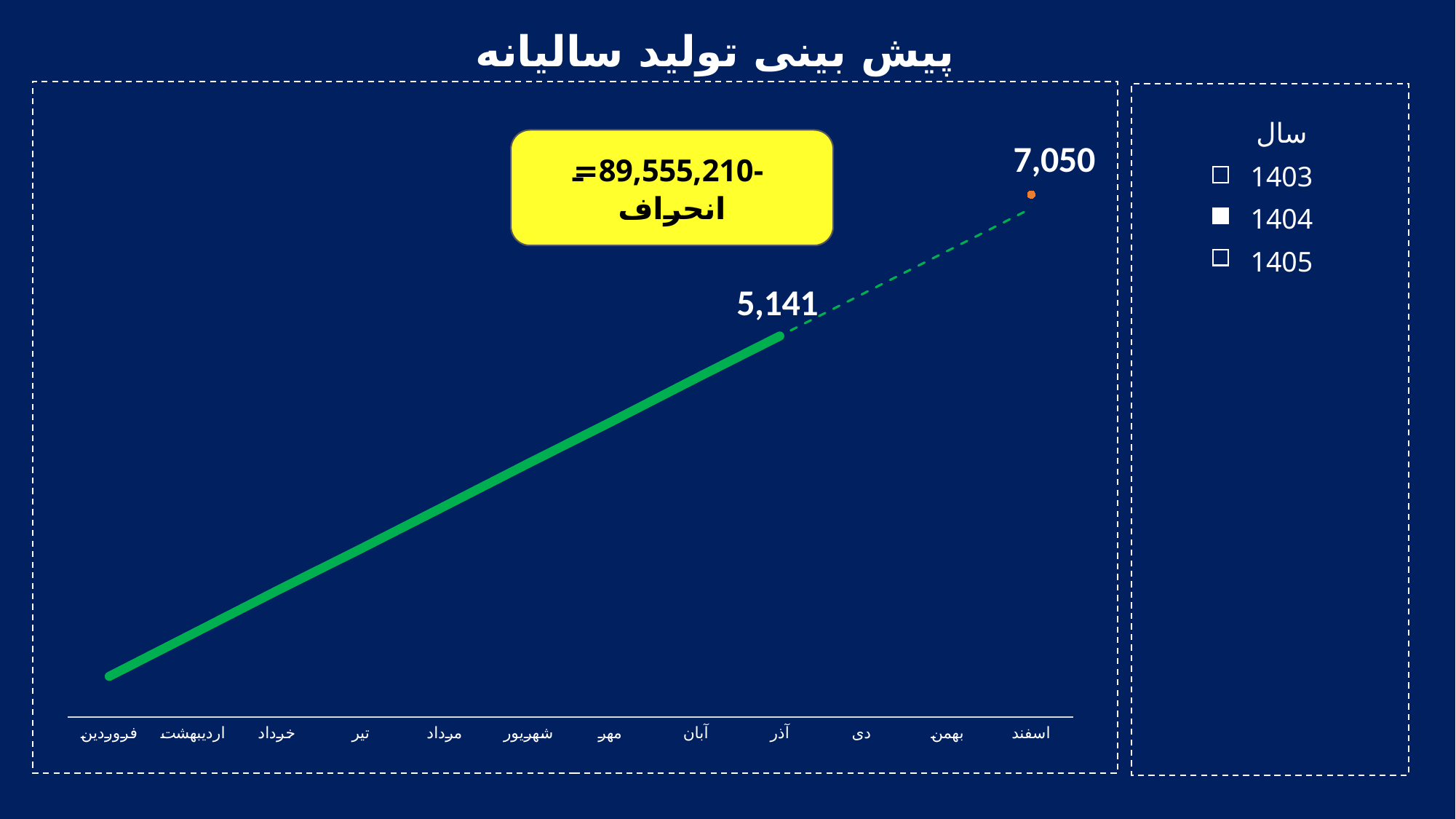
What value is labelled at آذر on the chart? 5,141 What value is labelled at اسفند on the chart? 7,050 What is the difference between the value at اسفند (7,050) and the value at آذر (5,141)? 1,909 What kind of chart is shown on the slide? Line chart Do the values rise or fall from فروردین to اسفند? Rise How many months are shown on the x axis? 12 Which is larger, the value at آذر or the value at اسفند? اسفند Which month is the first category on the x axis? فروردین What is the title of the chart? پیش بینی تولید سالیانه Which year is selected in the سال panel on the right? 1404